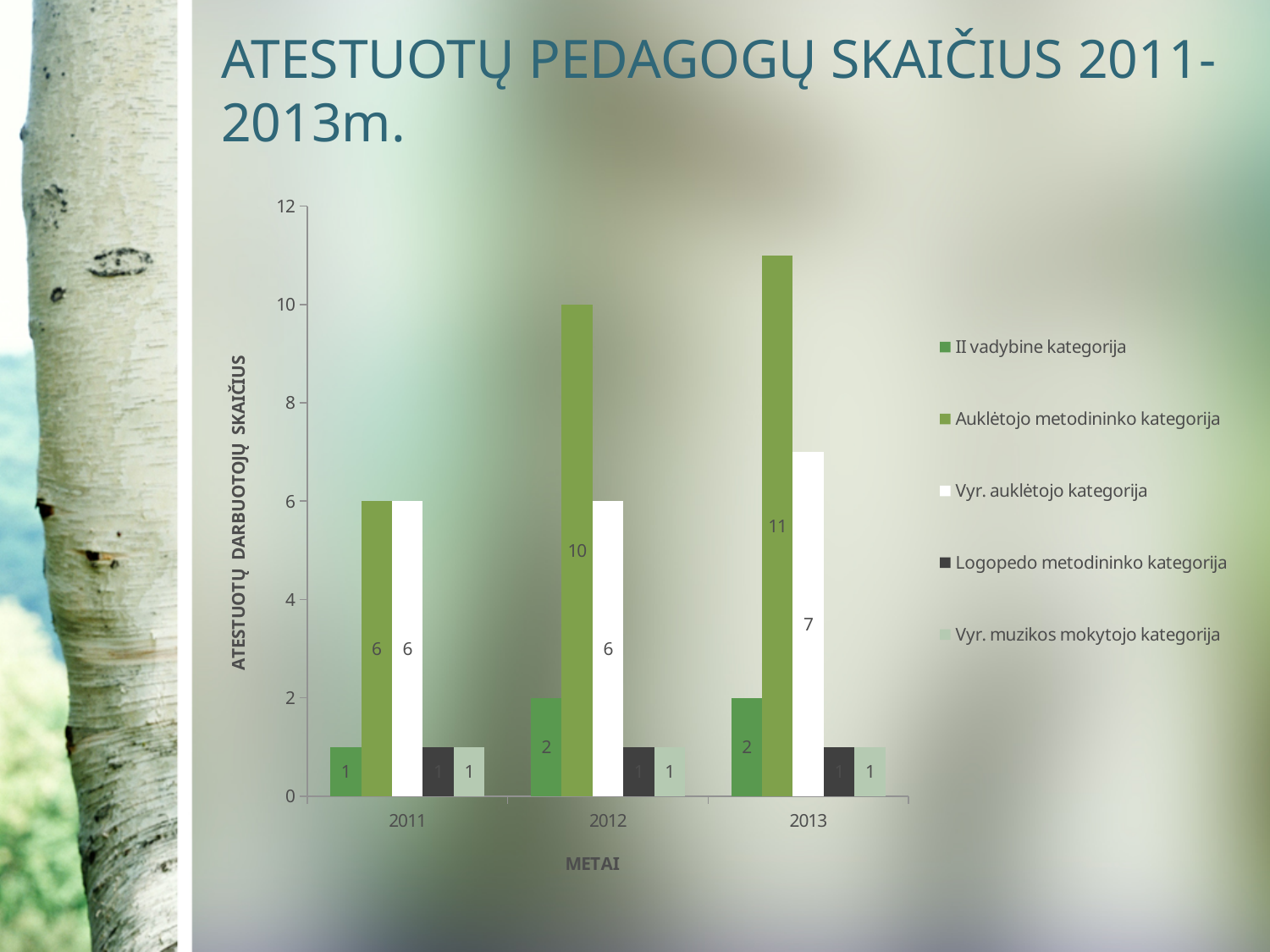
What is the value for II vadybine kategorija in 2011? 1 In which year is the value for Auklėtojo metodininko kategorija highest? 2013 What is the difference between the Auklėtojo metodininko kategorija values in 2013 and 2011? 5 In which year is the value for Auklėtojo metodininko kategorija lowest? 2011 What type of chart is shown on the slide? bar chart How many series does the legend list? 5 Which is larger in 2012: Auklėtojo metodininko kategorija or Vyr. auklėtojo kategorija? Auklėtojo metodininko kategorija Does the value for Auklėtojo metodininko kategorija rise or fall from 2011 to 2013? rise What is the value for Auklėtojo metodininko kategorija in 2012? 10 What is the title of the x axis? METAI What is the value for Vyr. auklėtojo kategorija in 2013? 7 How many years are shown on the x axis? 3